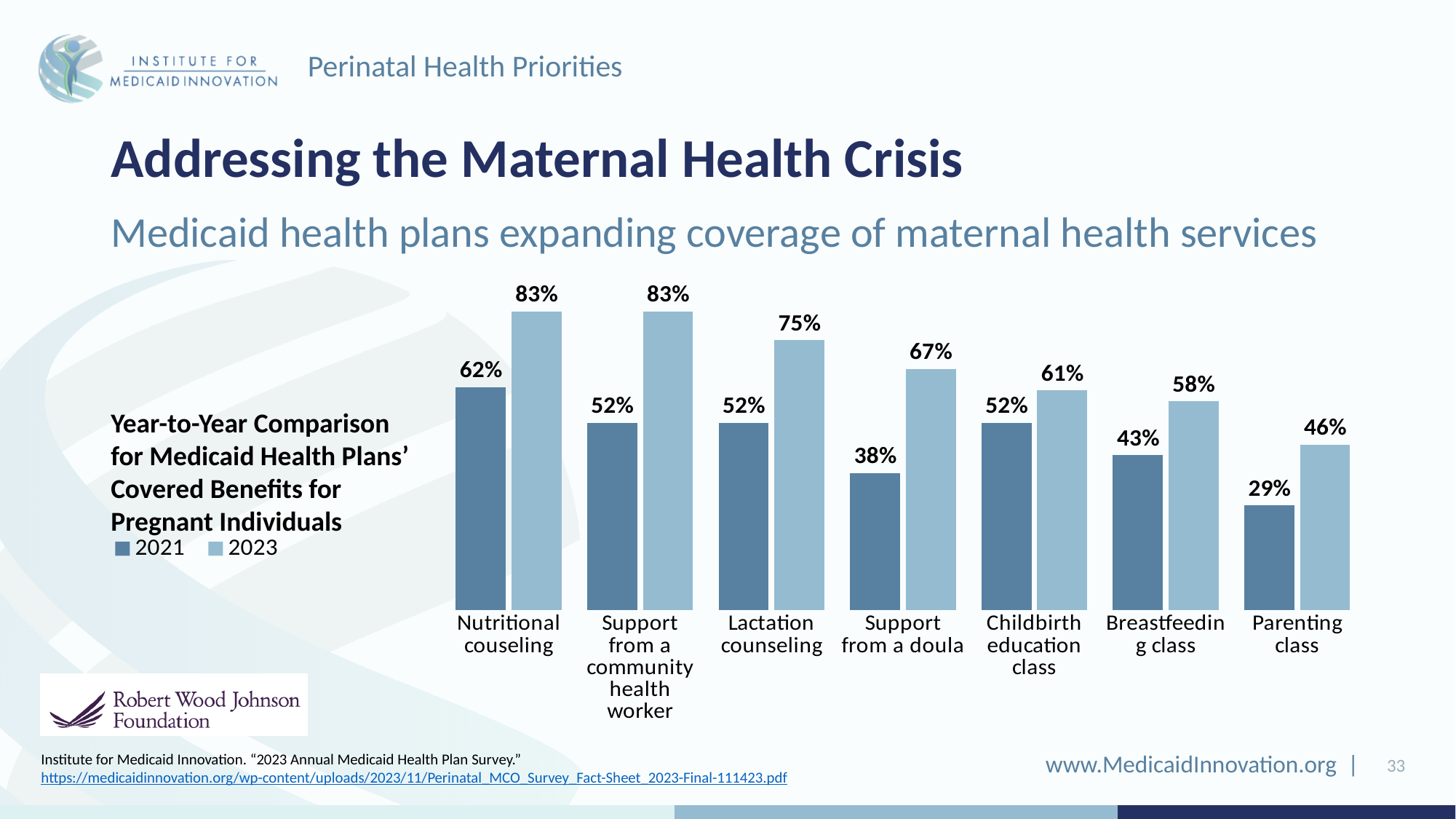
What was the 2023 value for Support from a doula? 67% Which category had the highest 2023 value? Nutritional couseling and Support from a community health worker (both 83%) How many categories are shown on the x axis? 7 Which years are listed in the chart legend? 2021 and 2023 How many series does the legend list? 2 What was the 2021 value for Lactation counseling? 52% Which category had the lowest 2021 value? Parenting class What kind of chart is shown on the slide? Bar chart Which is larger: the 2021 value for Nutritional couseling or the 2021 value for Childbirth education class? Nutritional couseling What is the difference between the 2023 and 2021 values for Support from a community health worker? 31 percentage points What is the difference between the 2023 and 2021 values for Breastfeeding class? 15 percentage points What was the 2021 value for Parenting class? 29%